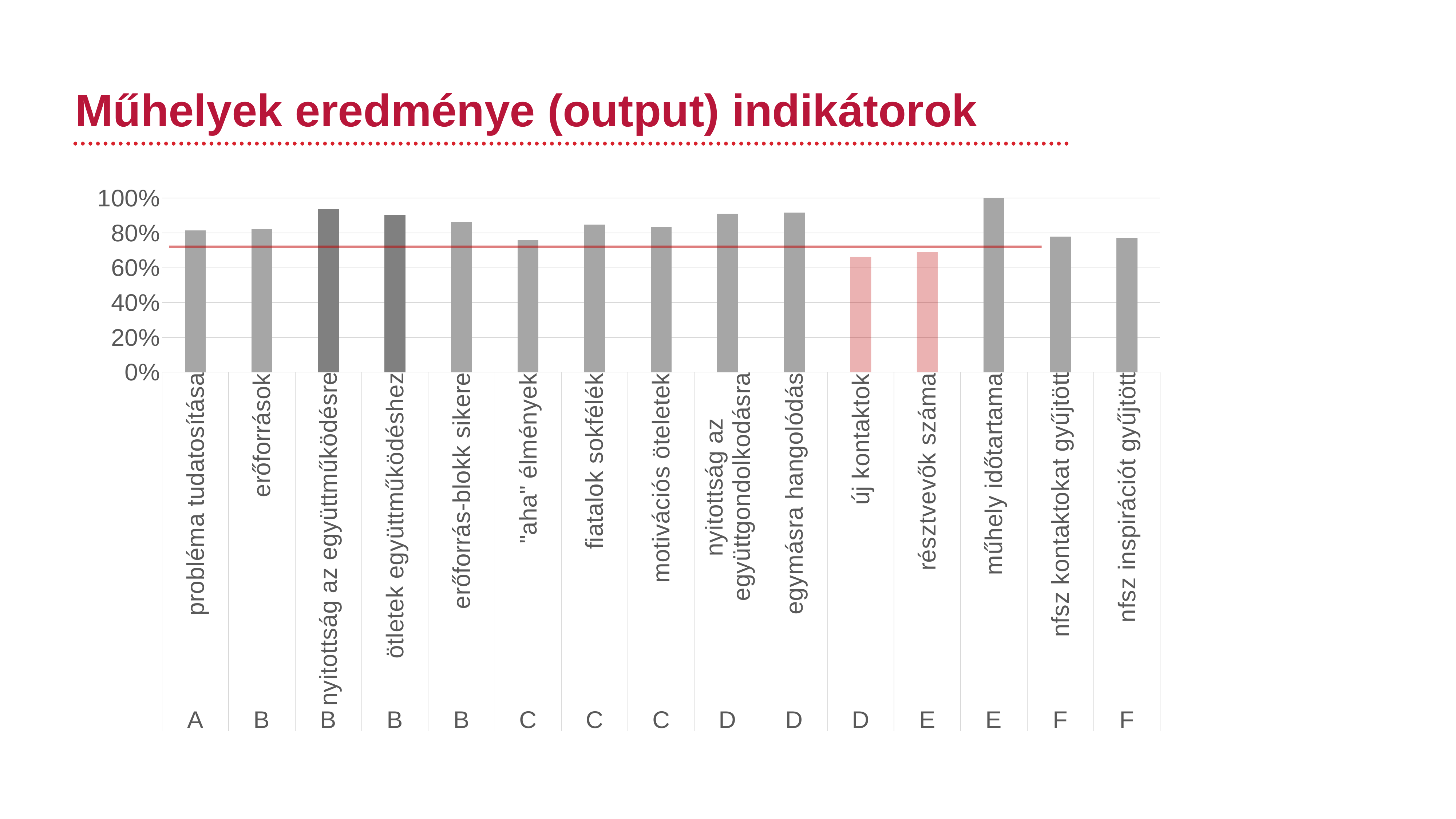
Is the value for "új kontaktok" greater or less than 60%? greater Which is larger, the value for "fiatalok sokfélék" or the value for ""aha" élmények"? fiatalok sokfélék How many bars (categories) are plotted in the chart? 15 What kind of chart is shown on the slide? bar chart Is the value for "egymásra hangolódás" greater or less than 80%? greater Which category has the highest value in the chart? műhely időtartama Is the value for "nyitottság az együttműködésre" greater or less than 80%? greater Which is larger, the value for "műhely időtartama" or the value for "új kontaktok"? műhely időtartama Which two bars are coloured pink/red instead of grey? új kontaktok and résztvevők száma